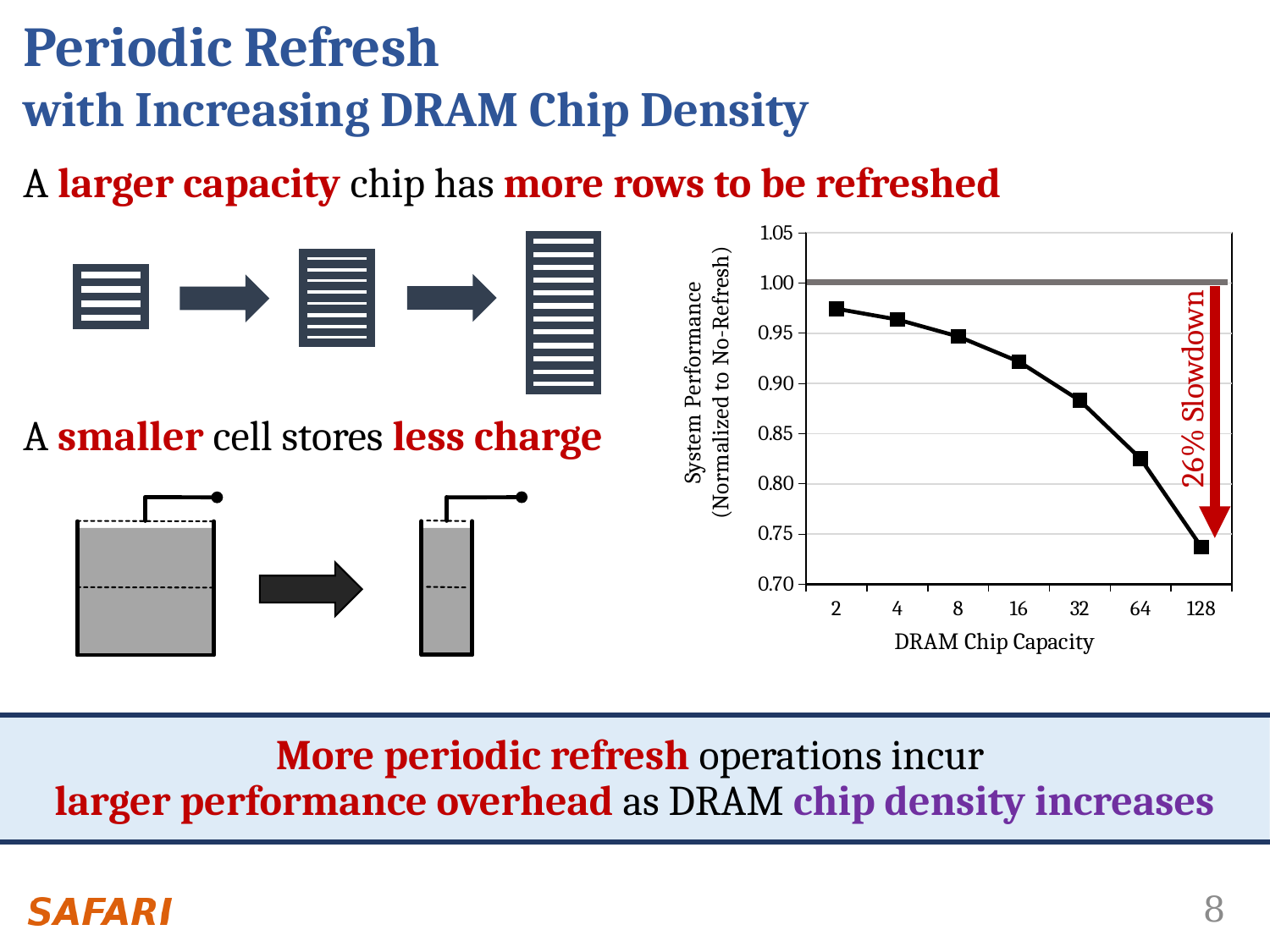
Is the system performance for a DRAM chip capacity of 16 greater or less than 0.90? greater Does system performance rise or fall as DRAM chip capacity increases along the x axis? fall Is the system performance for a DRAM chip capacity of 32 greater or less than 0.90? less What kind of chart is shown on the slide? line chart How many DRAM chip capacity points are plotted on the chart? 7 Which has higher system performance: a DRAM chip capacity of 8 or 64? 8 Is the system performance for a DRAM chip capacity of 128 greater or less than 0.75? less What is the label of the x axis of the chart? DRAM Chip Capacity What slowdown percentage is annotated by the red arrow on the chart? 26% Slowdown Which DRAM chip capacity has the lowest system performance? 128 Which DRAM chip capacity has the highest system performance? 2